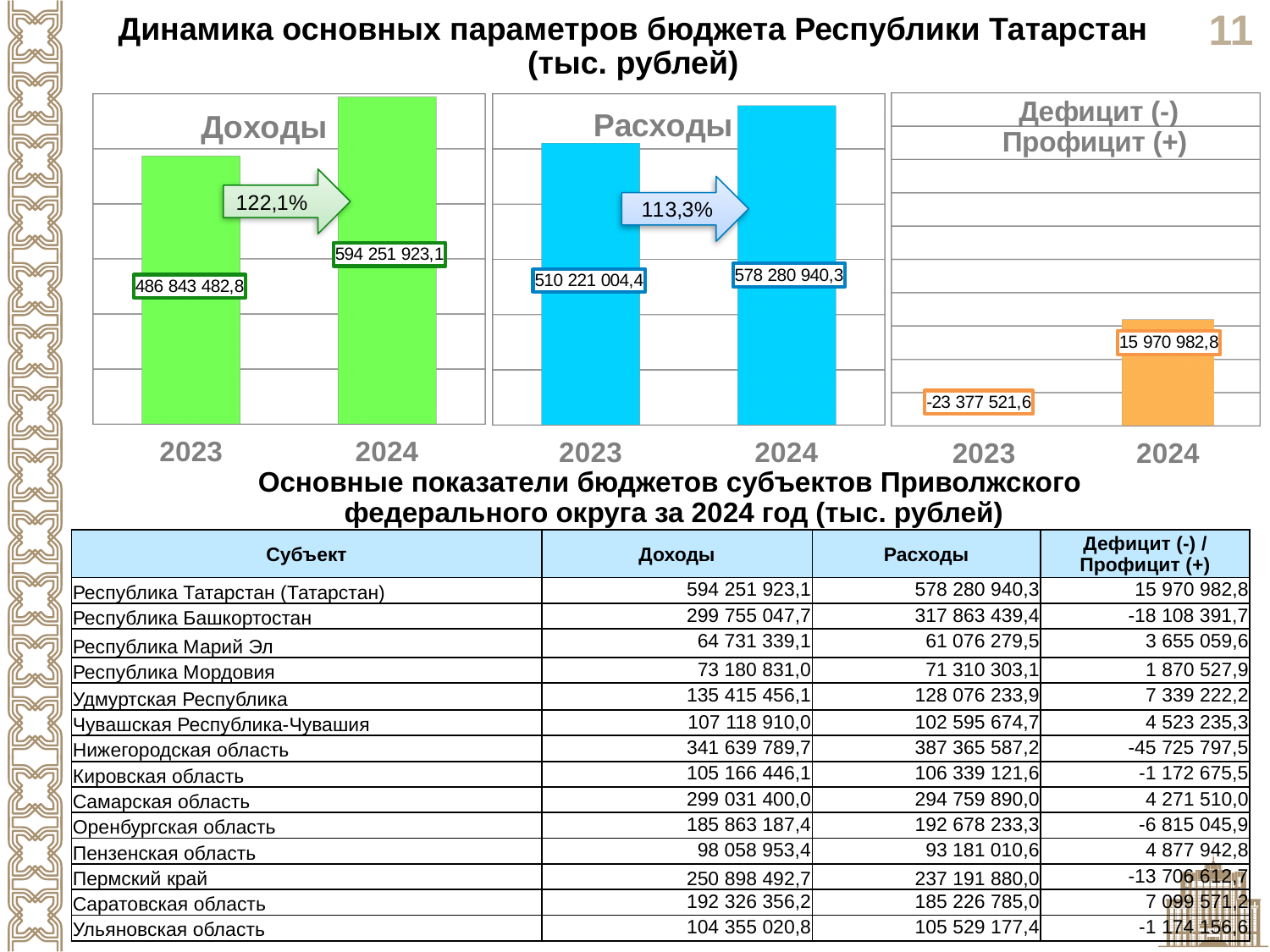
In the Расходы chart, what is the difference between the 2024 and 2023 values? 68 059 935,9 In the Расходы chart, what is the value for 2023? 510 221 004,4 In the Расходы chart, what is the value for 2024? 578 280 940,3 In the Доходы chart, by how much does the 2024 value exceed the 2023 value? 107 408 440,3 In the Расходы chart, which year has the higher value, 2023 or 2024? 2024 In the Доходы chart, what is the value for 2023? 486 843 482,8 What kind of chart is the Расходы chart? bar chart In the Доходы chart, what is the value for 2024? 594 251 923,1 In the Доходы chart, do the values rise or fall from 2023 to 2024? rise In the Дефицит (-) Профицит (+) chart, what is the value for 2024? 15 970 982,8 What percentage is shown on the arrow in the Доходы chart? 122,1% In the Дефицит (-) Профицит (+) chart, what is the value for 2023? -23 377 521,6